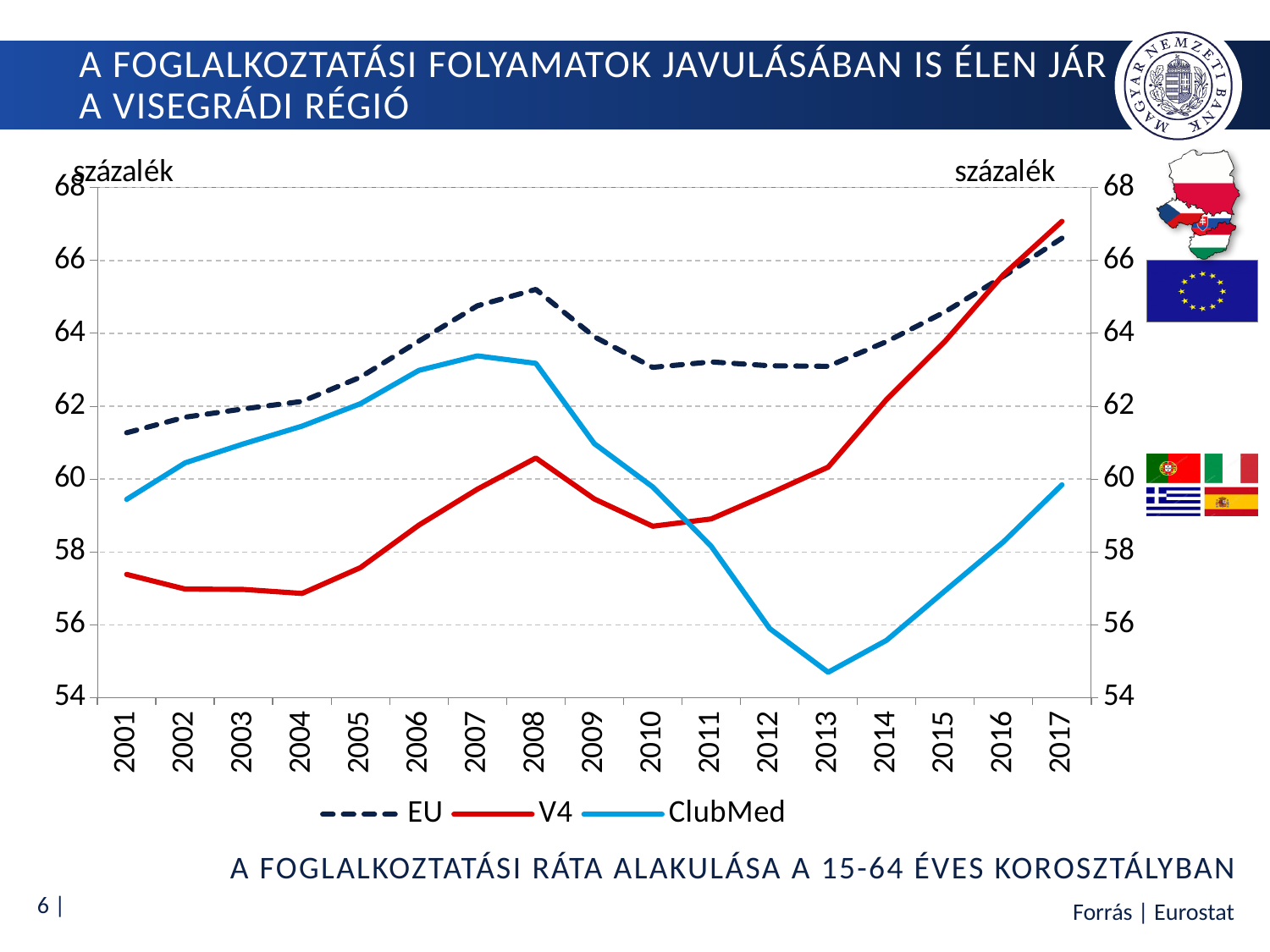
Is the V4 value for 2004 greater or less than 58? less What unit is shown on the y axis? százalék Is the V4 value for 2017 greater or less than 66? greater How many series does the legend list? 3 What kind of chart is shown on the slide? line chart Does the V4 line rise or fall between 2013 and 2017? rise Does the ClubMed line rise or fall between 2008 and 2013? fall In which year is the ClubMed series at its lowest? 2013 In 2001, which is larger, the ClubMed value or the V4 value? ClubMed In 2013, which is larger, the EU value or the V4 value? EU Is the ClubMed value for 2013 greater or less than 56? less How many years are shown on the x axis? 17